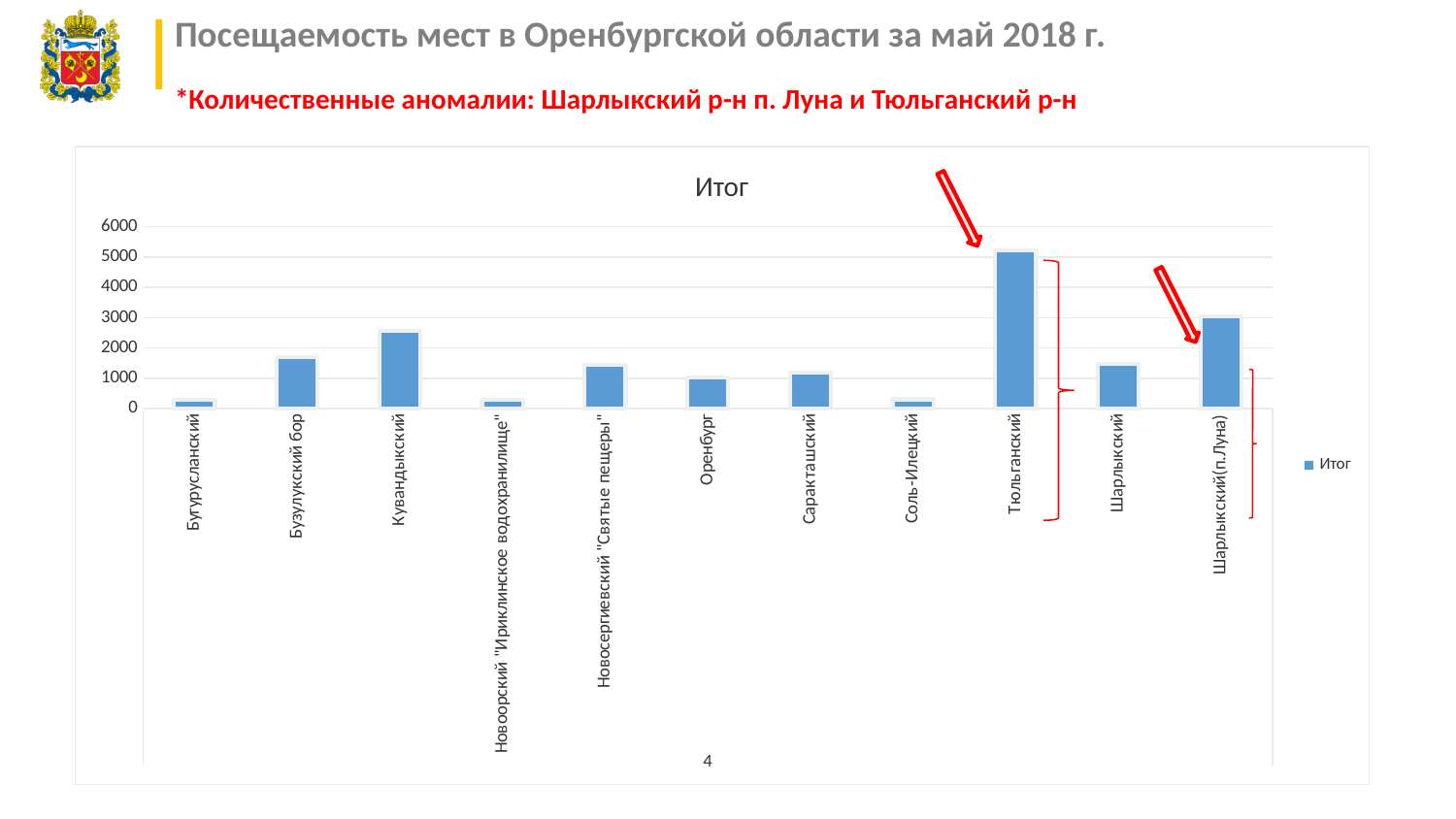
How many categories are plotted on the x axis of the chart? 11 What kind of chart is shown on the slide? bar chart Is the value for Шарлыкский(п.Луна) greater or less than 2000? greater Is the value for Бугурусланский greater or less than 1000? less How many series does the chart's legend list? 1 Which category has the highest value in the chart? Тюльганский What is the name of the series shown in the chart's legend? Итог Is the value for Тюльганский greater or less than 4000? greater What is the title of the chart? Итог Which has the larger value, Кувандыкский or Бузулукский бор? Кувандыкский Which has the larger value, Тюльганский or Шарлыкский(п.Луна)? Тюльганский